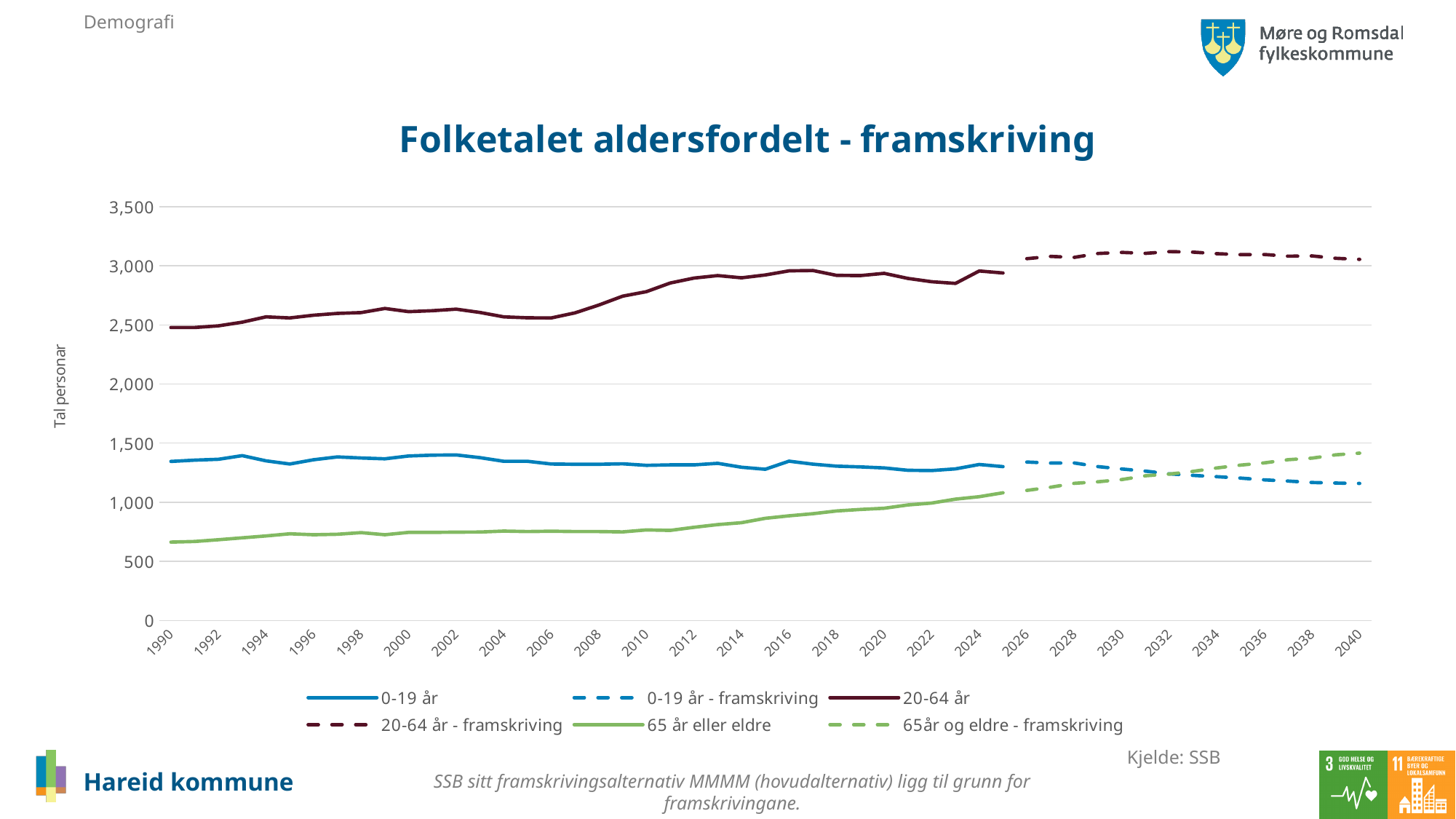
What kind of chart is shown on the slide? line chart Which series has the highest values across the whole chart? 20-64 år - framskriving How many series does the legend list? 6 Is the value for 65 år eller eldre in 1990 greater or less than 1,000? less Is the value for 0-19 år in 2000 greater or less than 1,500? less Is the value for 20-64 år in 2016 greater or less than 2,500? greater In 2040, which is larger: 0-19 år - framskriving or 65år og eldre - framskriving? 65år og eldre - framskriving What source is cited below the chart? Kjelde: SSB Does the 0-19 år - framskriving series rise or fall from 2026 to 2040? fall Does the 65 år eller eldre series rise or fall from 1990 to 2024? rise What is the title of the chart? Folketalet aldersfordelt - framskriving